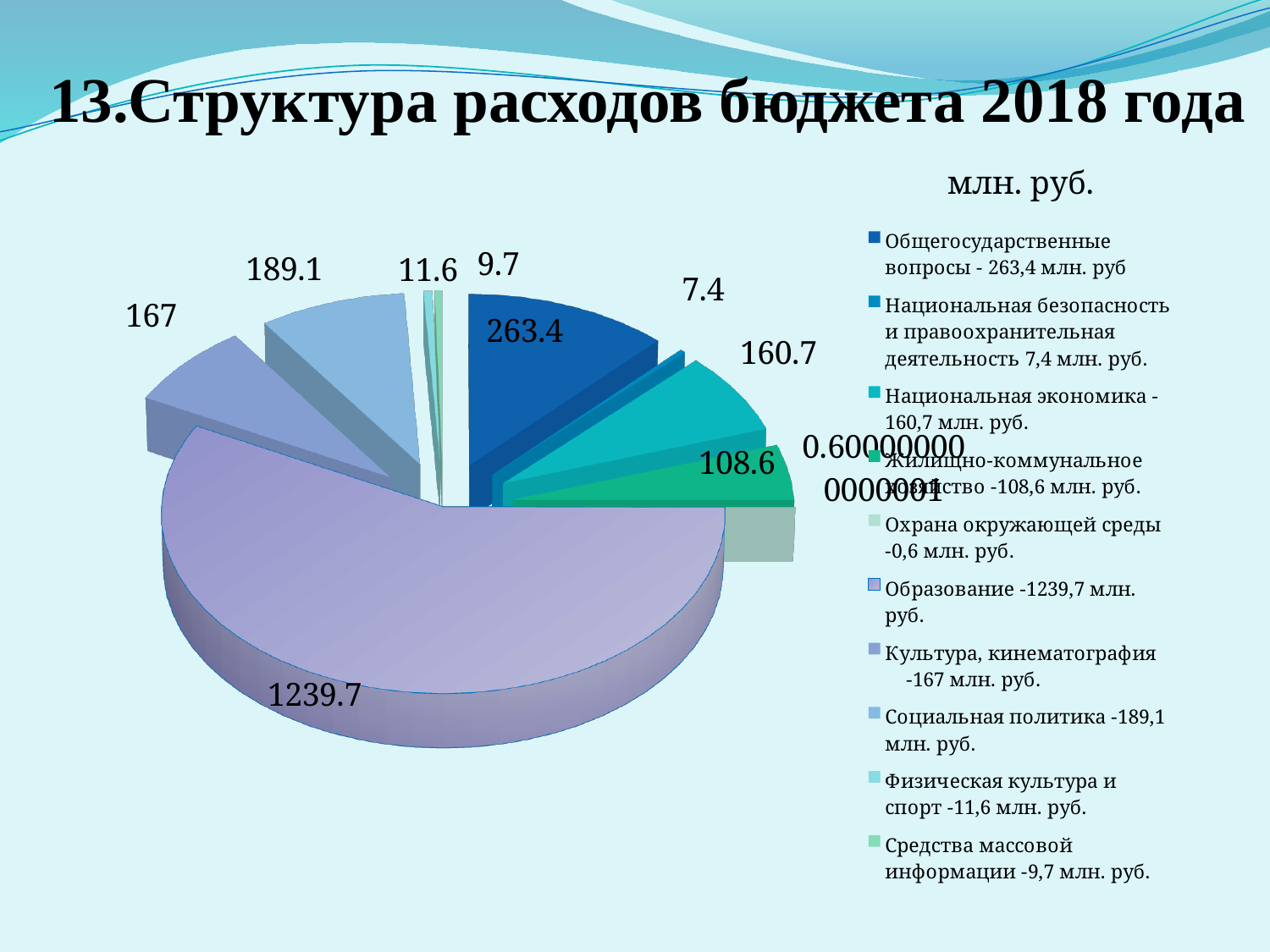
What value is labelled on the slice for Национальная экономика? 160.7 What kind of chart is shown on the slide? pie chart What value is labelled on the slice for Социальная политика? 189.1 How many slices does the pie chart have? 10 What value is labelled on the slice for Образование? 1239.7 What is the difference between the values for Общегосударственные вопросы and Национальная экономика? 102.7 What unit is stated above the legend of the chart? млн. руб. Which is larger, the value for Физическая культура и спорт or the value for Средства массовой информации? Физическая культура и спорт What value is labelled on the slice for Общегосударственные вопросы? 263.4 What is the difference between the values for Социальная политика and Культура, кинематография? 22.1 Which category has the smallest slice of the pie? Охрана окружающей среды Which category has the largest slice of the pie? Образование